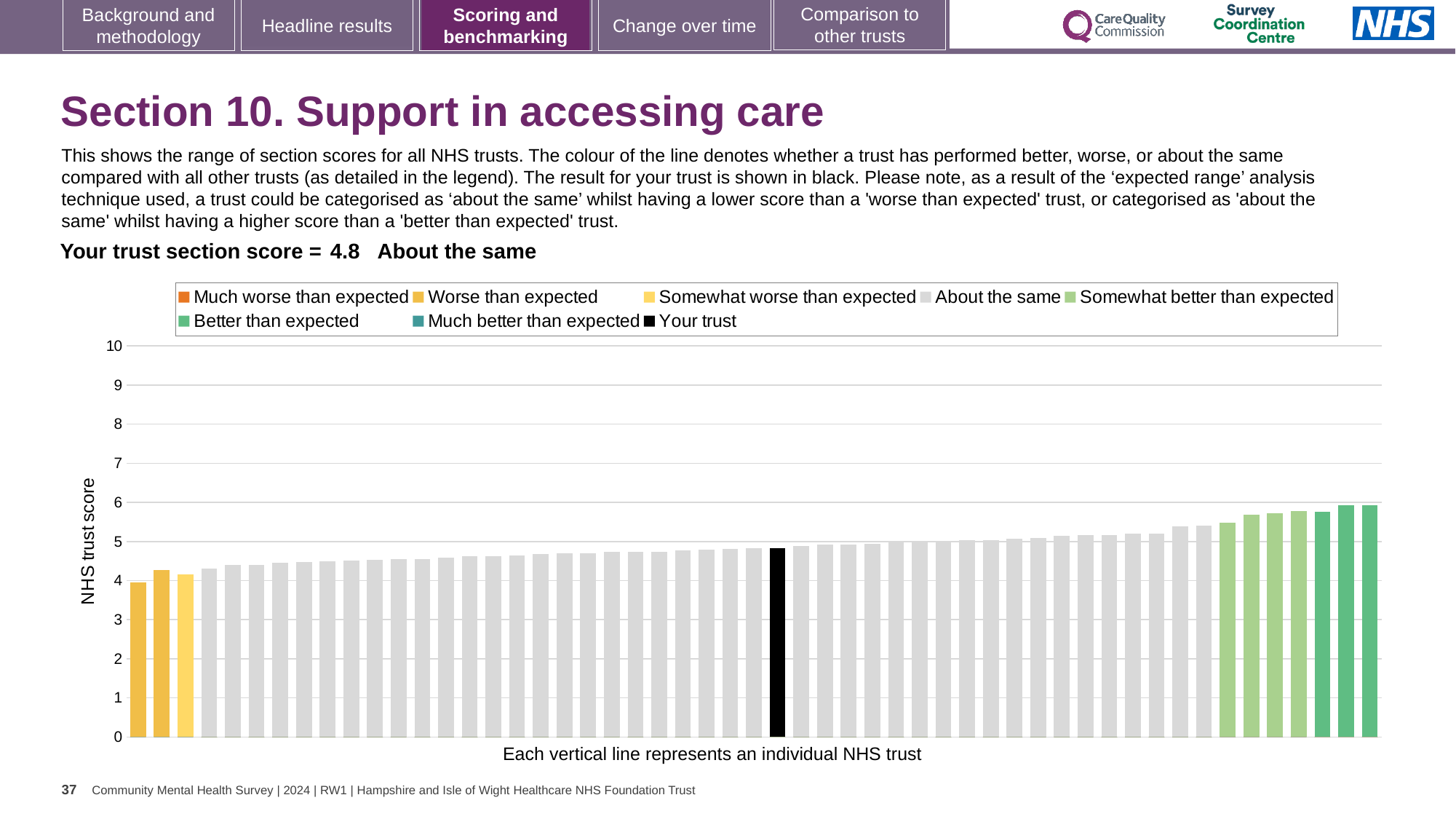
Is the value of the shortest bar in the chart greater or less than 5? less Which legend category does the shortest bar on the left of the chart belong to? Worse than expected What is the label on the vertical axis of the chart? NHS trust score Which legend category do the tallest bars on the right of the chart belong to? Better than expected What kind of chart is shown on the slide? bar chart Is the value of the tallest bar in the chart greater or less than 5? greater What is the section score for your trust shown on the slide? 4.8 Which performance category is your trust placed in for Section 10? About the same Do the bar values rise or fall from left to right along the x axis? rise Is the value of the black 'Your trust' bar greater or less than 5? less How many categories does the chart legend list? 8 Which is larger: the value of the black 'Your trust' bar or the value of the rightmost bar? the rightmost bar